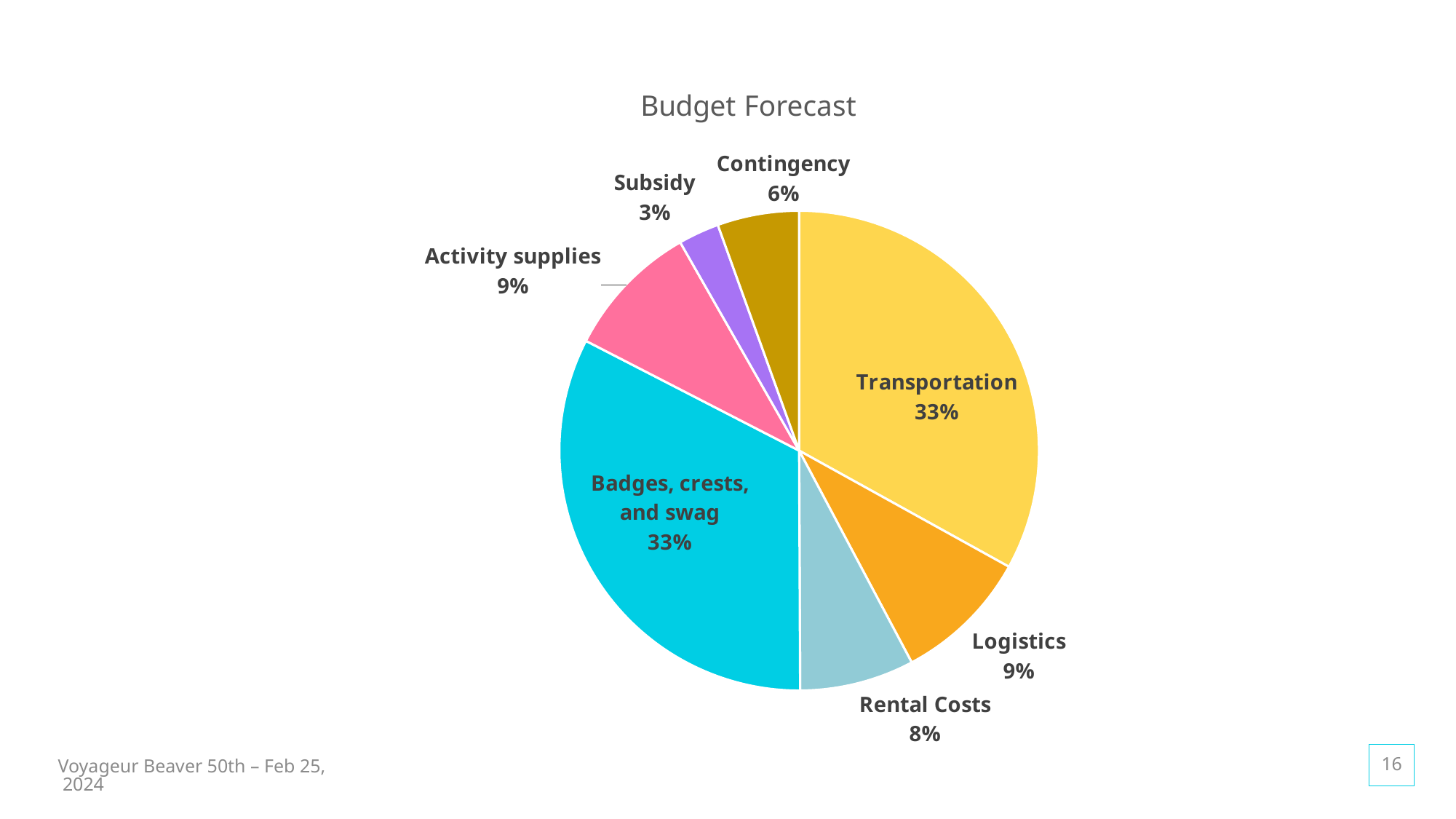
What colour is the Badges, crests, and swag slice? cyan Which category has the smallest slice of the pie? Subsidy What is the difference in percentage points between Activity supplies and Subsidy? 6 What share of the budget is allocated to Rental Costs? 8% What share of the budget is allocated to Transportation? 33% What is the difference in percentage points between Transportation and Contingency? 27 What is the title of the chart? Budget Forecast Which is larger, the share for Logistics or the share for Rental Costs? Logistics What kind of chart is shown on the slide? pie chart What percentage is shown for Contingency? 6% How many slices does the pie chart have? 7 What percentage is shown for Subsidy? 3%